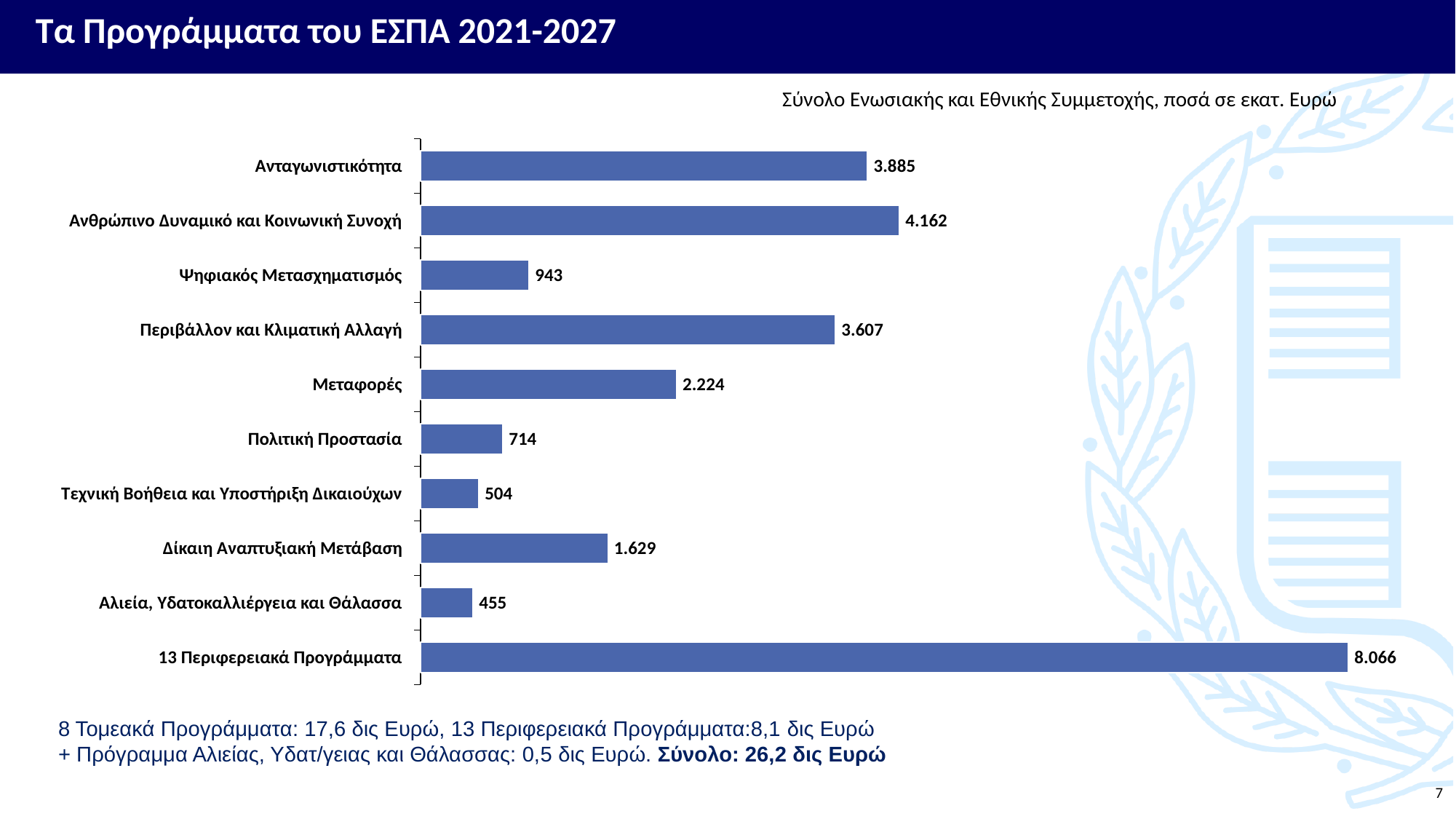
What unit does the chart subtitle say the amounts are in? εκατ. Ευρώ What is the value for Δίκαιη Αναπτυξιακή Μετάβαση? 1.629 What is the value for Ψηφιακός Μετασχηματισμός? 943 Which category has the lowest value? Αλιεία, Υδατοκαλλιέργεια και Θάλασσα What is the value for Μεταφορές? 2.224 What is the value for Ανταγωνιστικότητα? 3.885 What kind of chart is shown on the slide? Bar chart Which category has the highest value? 13 Περιφερειακά Προγράμματα What is the difference between the values for Ανθρώπινο Δυναμικό και Κοινωνική Συνοχή and Ανταγωνιστικότητα? 277 What is the difference between the values for Ψηφιακός Μετασχηματισμός and Πολιτική Προστασία? 229 How many categories are shown in the chart? 10 Which is larger, the value for Περιβάλλον και Κλιματική Αλλαγή or the value for Μεταφορές? Περιβάλλον και Κλιματική Αλλαγή